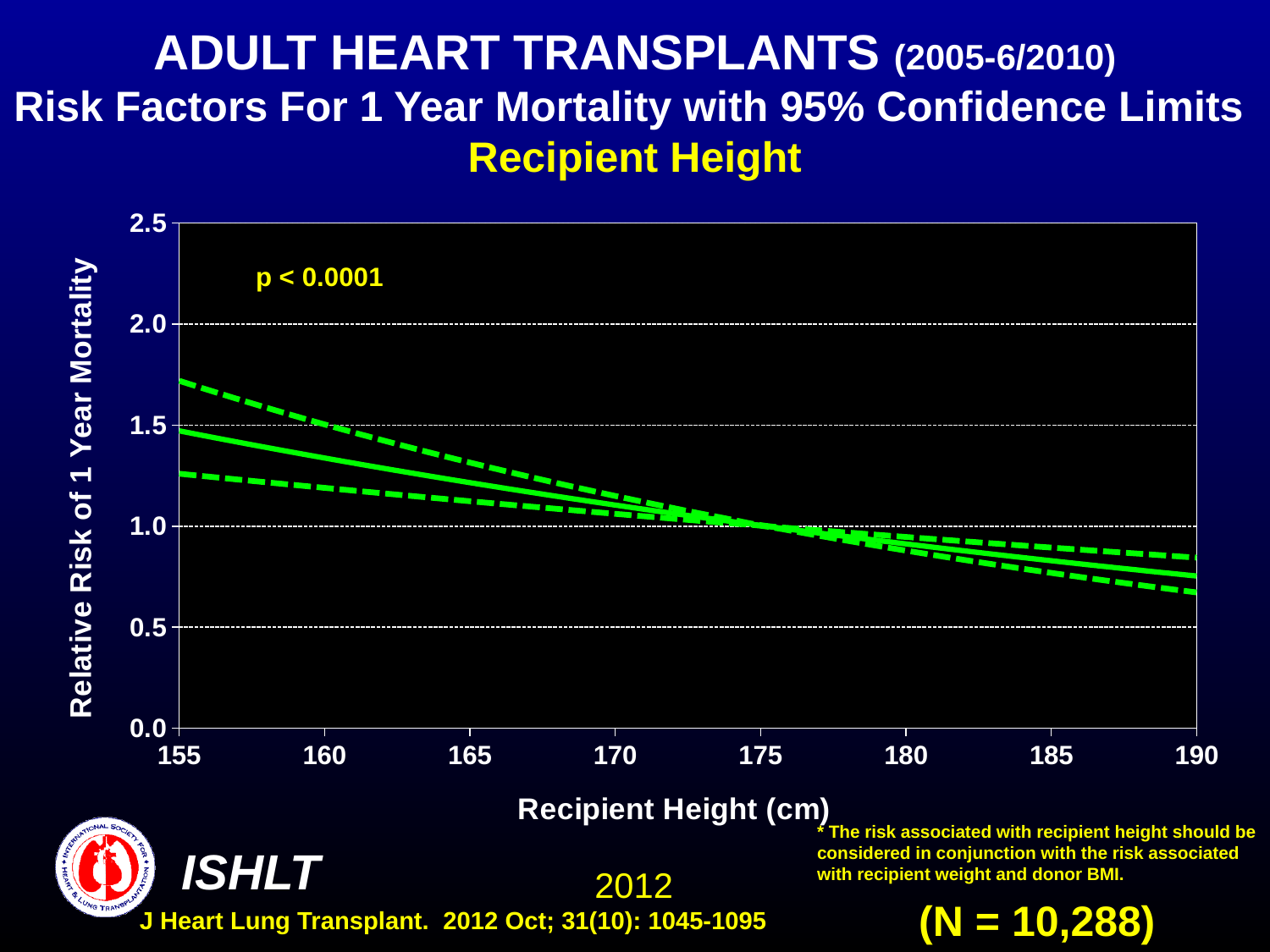
Is the relative risk on the solid line at a recipient height of 155 cm greater or less than 1.0? greater How many lines are plotted on the chart? 3 On the solid line, is the relative risk higher at a recipient height of 155 cm or at 190 cm? 155 cm Is the lower dashed confidence limit at a recipient height of 190 cm greater or less than 0.5? greater How many tick labels are shown on the x axis? 8 Is the relative risk on the solid line at a recipient height of 190 cm greater or less than 1.0? less What is the title of the x axis? Recipient Height (cm) What p-value is printed on the chart? p < 0.0001 Does the relative risk of 1 year mortality rise or fall as recipient height increases from 155 cm to 190 cm? fall What kind of chart is shown on the slide? line chart